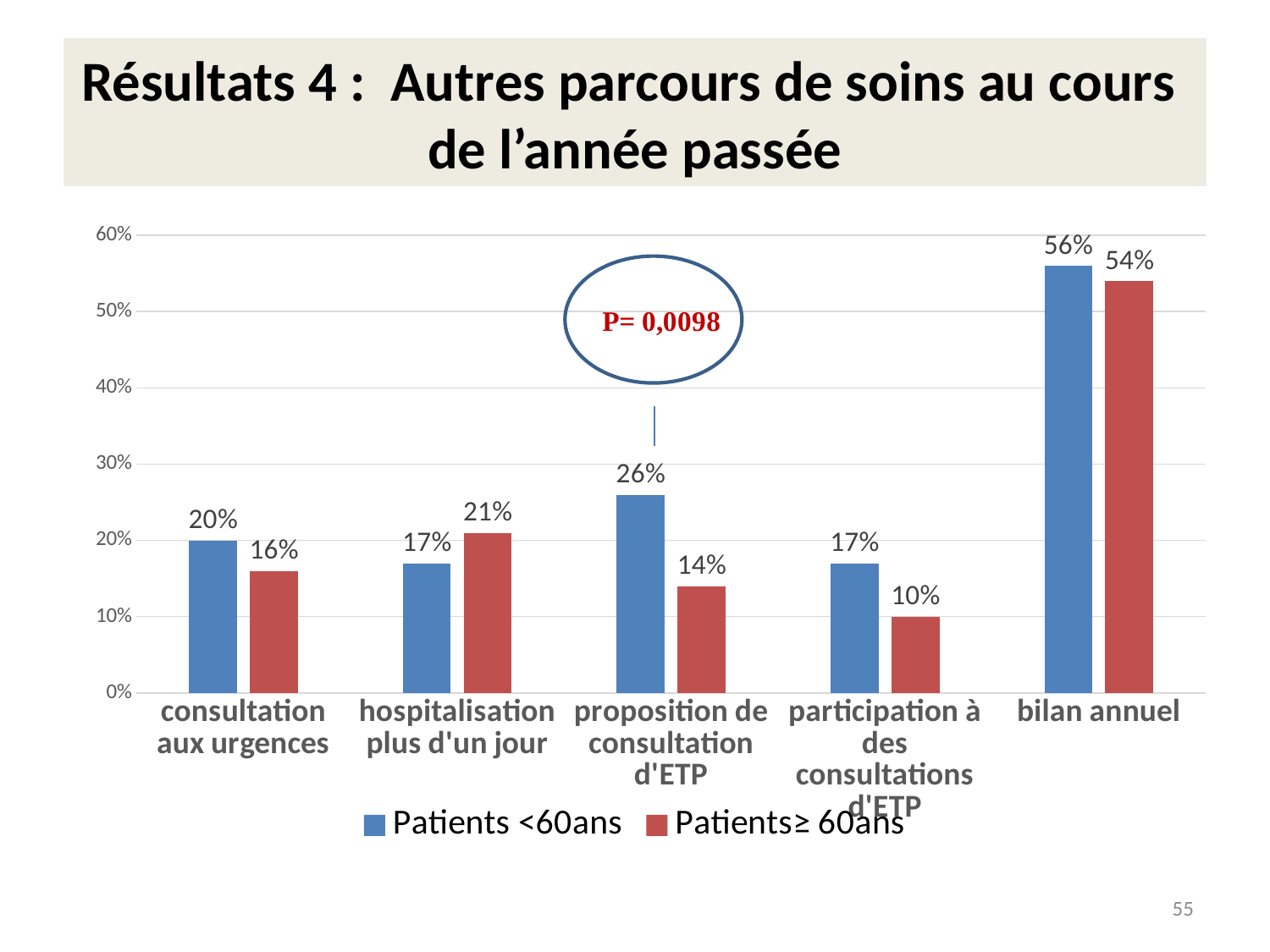
How many categories are shown on the x axis? 5 Which category has the lowest value for Patients≥ 60ans? participation à des consultations d'ETP What P value is shown in the circle above the 'proposition de consultation d'ETP' bars? P= 0,0098 What is the difference between Patients <60ans and Patients≥ 60ans for 'proposition de consultation d'ETP'? 12% Is the value for Patients≥ 60ans for 'bilan annuel' greater or less than 50%? greater For 'hospitalisation plus d'un jour', which series has the larger value, Patients <60ans or Patients≥ 60ans? Patients≥ 60ans Which category has the highest value for Patients <60ans? bilan annuel How many series does the legend list? 2 What is the value for Patients≥ 60ans for 'participation à des consultations d'ETP'? 10% What is the value for Patients≥ 60ans for 'hospitalisation plus d'un jour'? 21% What is the value for Patients <60ans for 'consultation aux urgences'? 20% What kind of chart is shown on the slide? bar chart